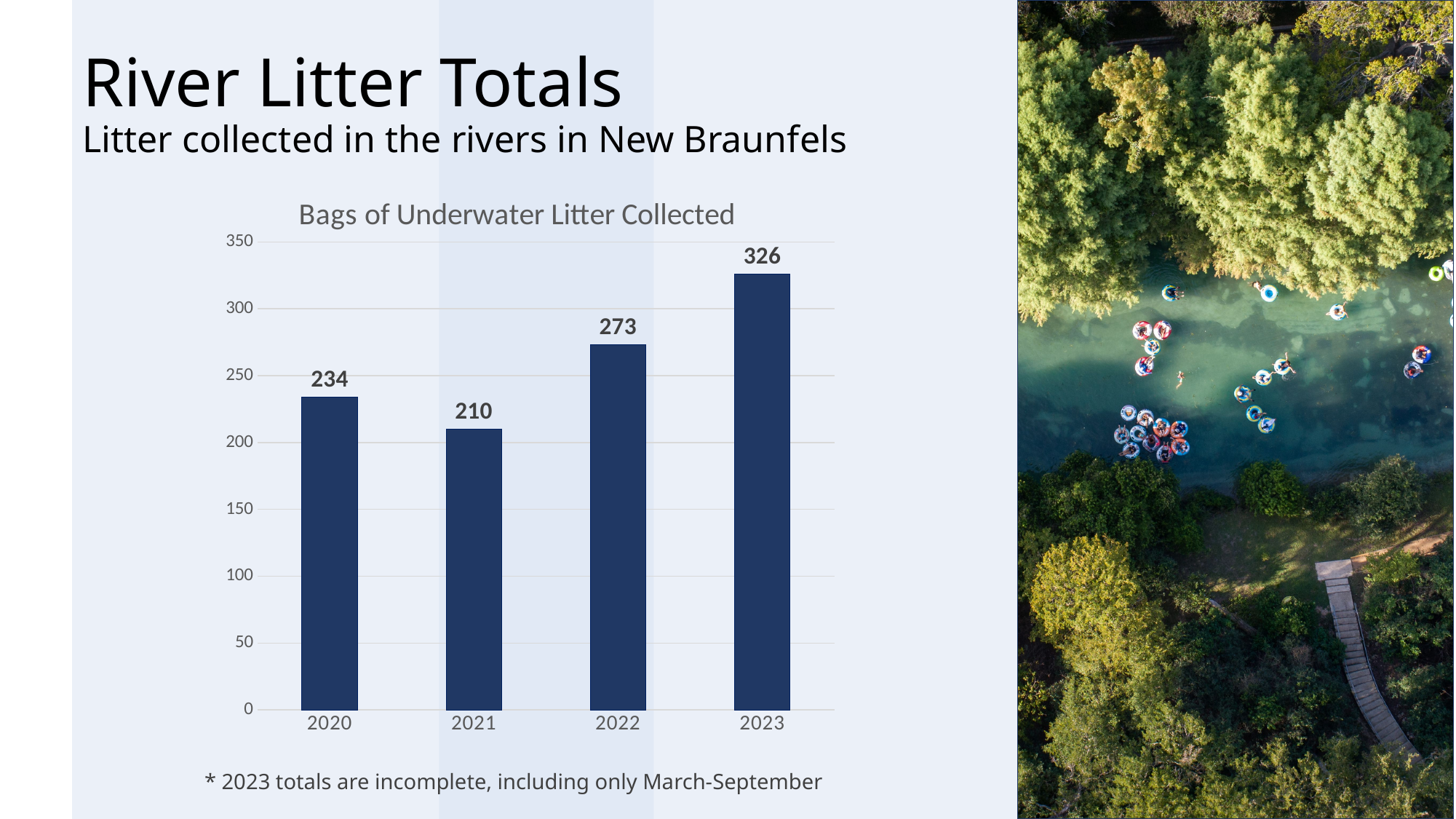
What is the difference in bags collected between 2020 and 2021? 24 What is the difference in bags collected between 2023 and 2022? 53 What type of chart is used to show the bags of underwater litter collected? Bar chart What is the title of the chart? Bags of Underwater Litter Collected How many bags of underwater litter were collected in 2022? 273 How many bags of underwater litter were collected in 2021? 210 Which year had more bags of litter collected, 2020 or 2022? 2022 Which year had the lowest number of bags of underwater litter collected? 2021 How many bags of underwater litter were collected in 2023? 326 Which year had the highest number of bags of underwater litter collected? 2023 How many bags of underwater litter were collected in 2020? 234 How many years are shown on the chart? 4